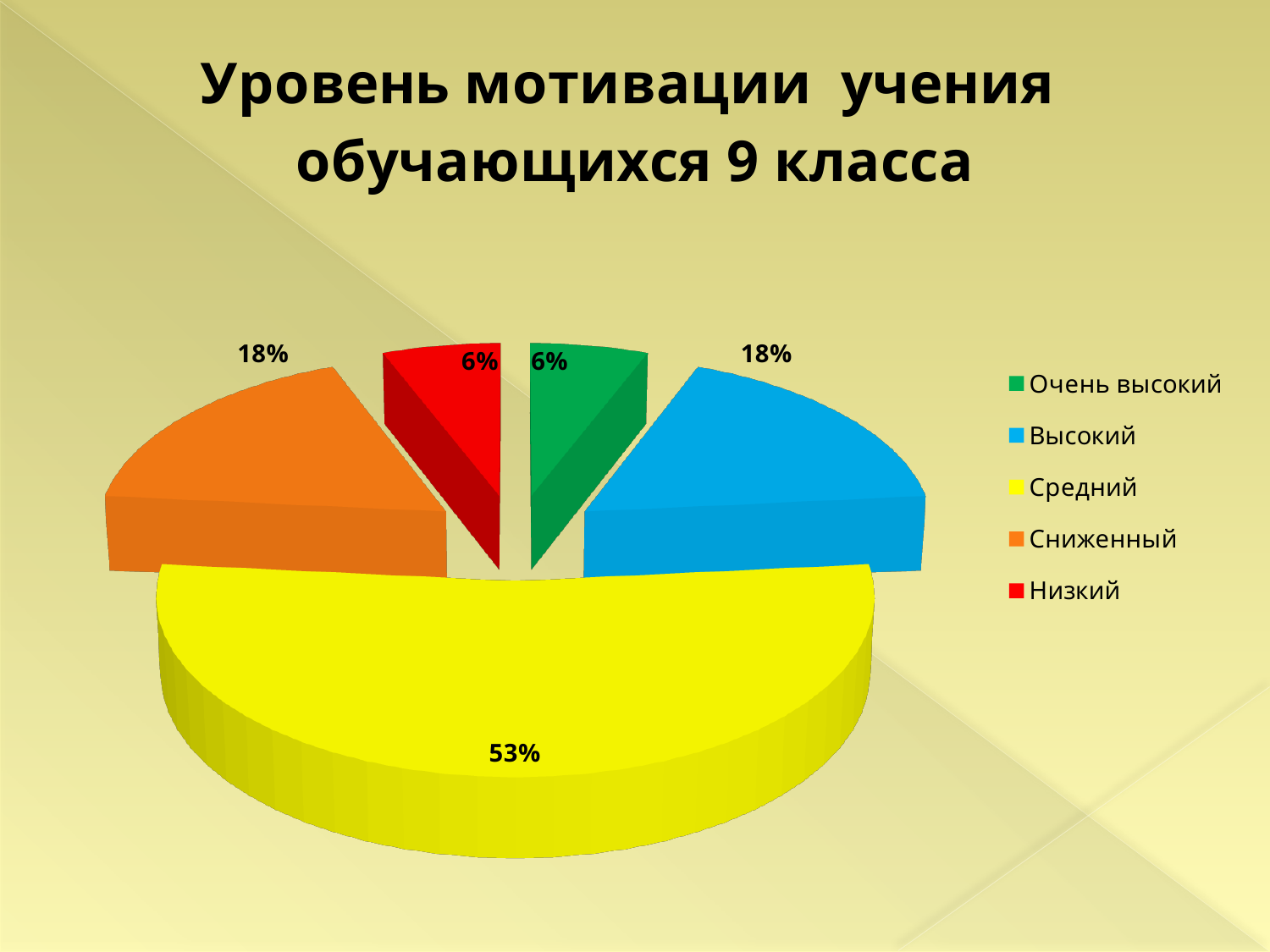
What colour is the Низкий slice in the pie chart? Red Which is larger, the value for Средний or the value for Сниженный? Средний Which category has the largest slice of the pie? Средний What is the value shown for Высокий? 18% What kind of chart is shown on the slide? Pie chart What share of the pie does the Средний slice represent? 53% What is the difference between the values for Средний and Высокий? 35% What is the value shown for Низкий? 6% What is the value shown for Очень высокий? 6% What is the difference between the values for Сниженный and Низкий? 12% What is the value shown for Сниженный? 18% How many slices does the pie chart have? 5